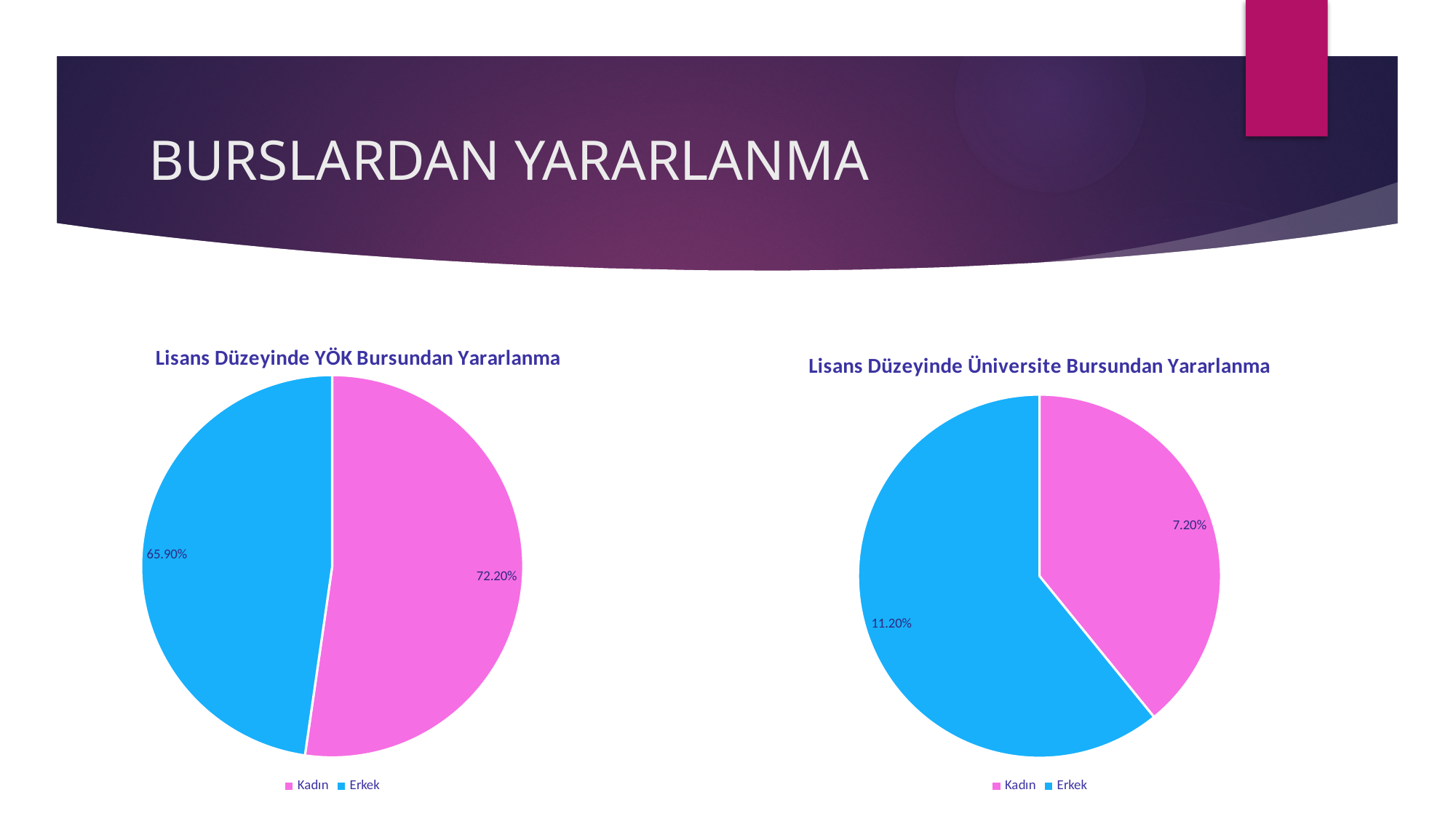
How many entries does the legend of the right chart (Üniversite Bursu) list? 2 In the chart titled "Lisans Düzeyinde YÖK Bursundan Yararlanma", what is the difference between the Kadın and Erkek values? 6.30% In the chart titled "Lisans Düzeyinde YÖK Bursundan Yararlanma", what is the value shown for Erkek? 65.90% In the chart titled "Lisans Düzeyinde Üniversite Bursundan Yararlanma", what is the value shown for Erkek? 11.20% In the chart titled "Lisans Düzeyinde Üniversite Bursundan Yararlanma", what is the difference between the Erkek and Kadın values? 4.00% In the left chart (YÖK Bursu), which category has the larger value, Kadın or Erkek? Kadın In the chart titled "Lisans Düzeyinde YÖK Bursundan Yararlanma", what is the value shown for Kadın? 72.20% In the chart titled "Lisans Düzeyinde Üniversite Bursundan Yararlanma", what is the value shown for Kadın? 7.20% How many slices does the chart titled "Lisans Düzeyinde YÖK Bursundan Yararlanma" have? 2 What type of chart is used on the left side of the slide? Pie chart In the right chart (Üniversite Bursu), which category has the larger value, Kadın or Erkek? Erkek In the right chart (Üniversite Bursu), which category has the lowest value? Kadın